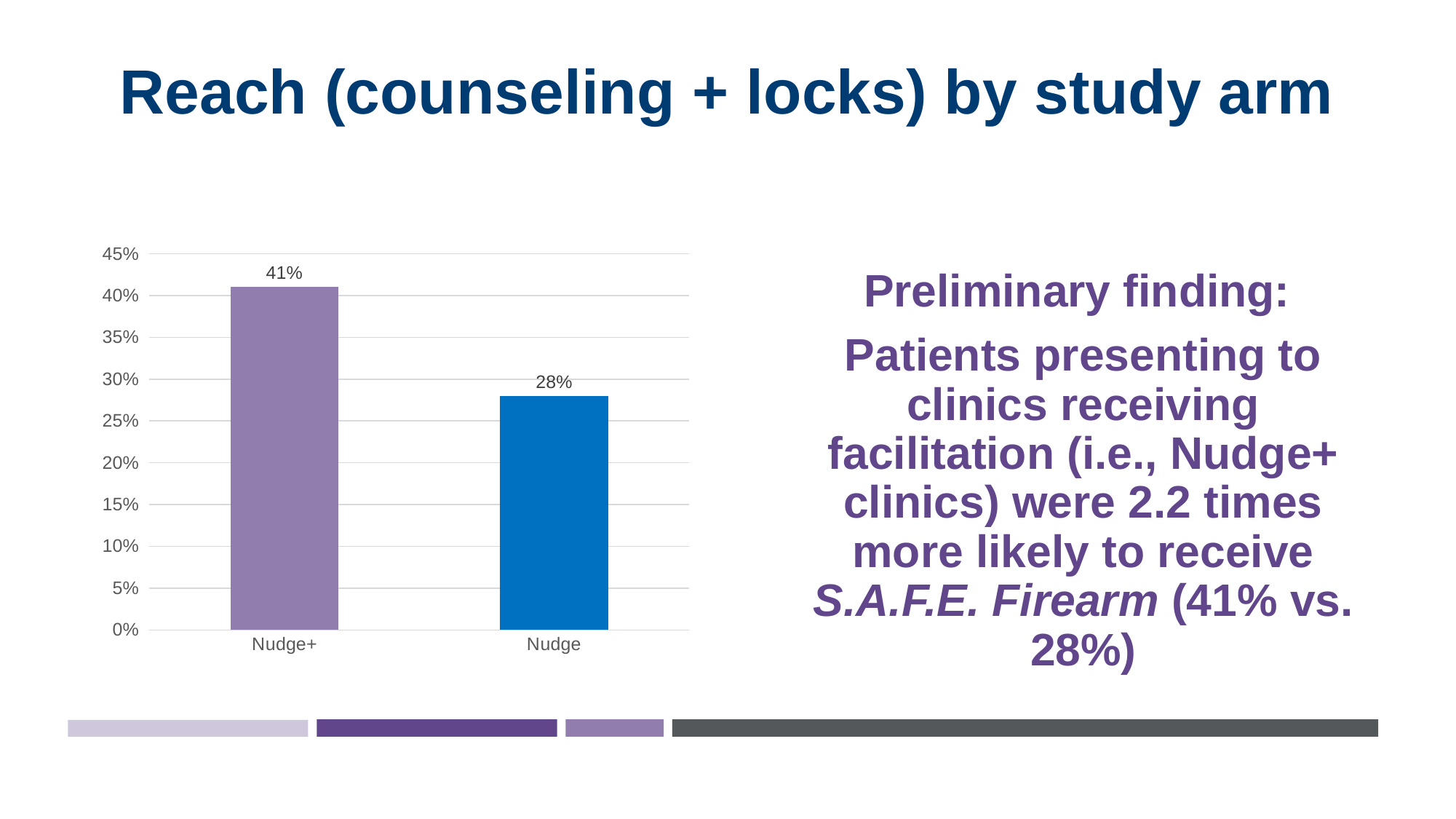
What kind of chart is shown on the slide? bar chart Is the value for Nudge greater or less than 30%? less What is the value for Nudge+? 41% How many study arms are shown in the chart? 2 Which study arm has the lowest value? Nudge What is the value for Nudge? 28% Which is larger, the value for Nudge+ or the value for Nudge? Nudge+ What is the title of the slide? Reach (counseling + locks) by study arm Which study arm has the highest value? Nudge+ What is the highest value shown on the y axis? 45% Is the value for Nudge+ greater or less than 40%? greater What is the difference between the values for Nudge+ and Nudge? 13%